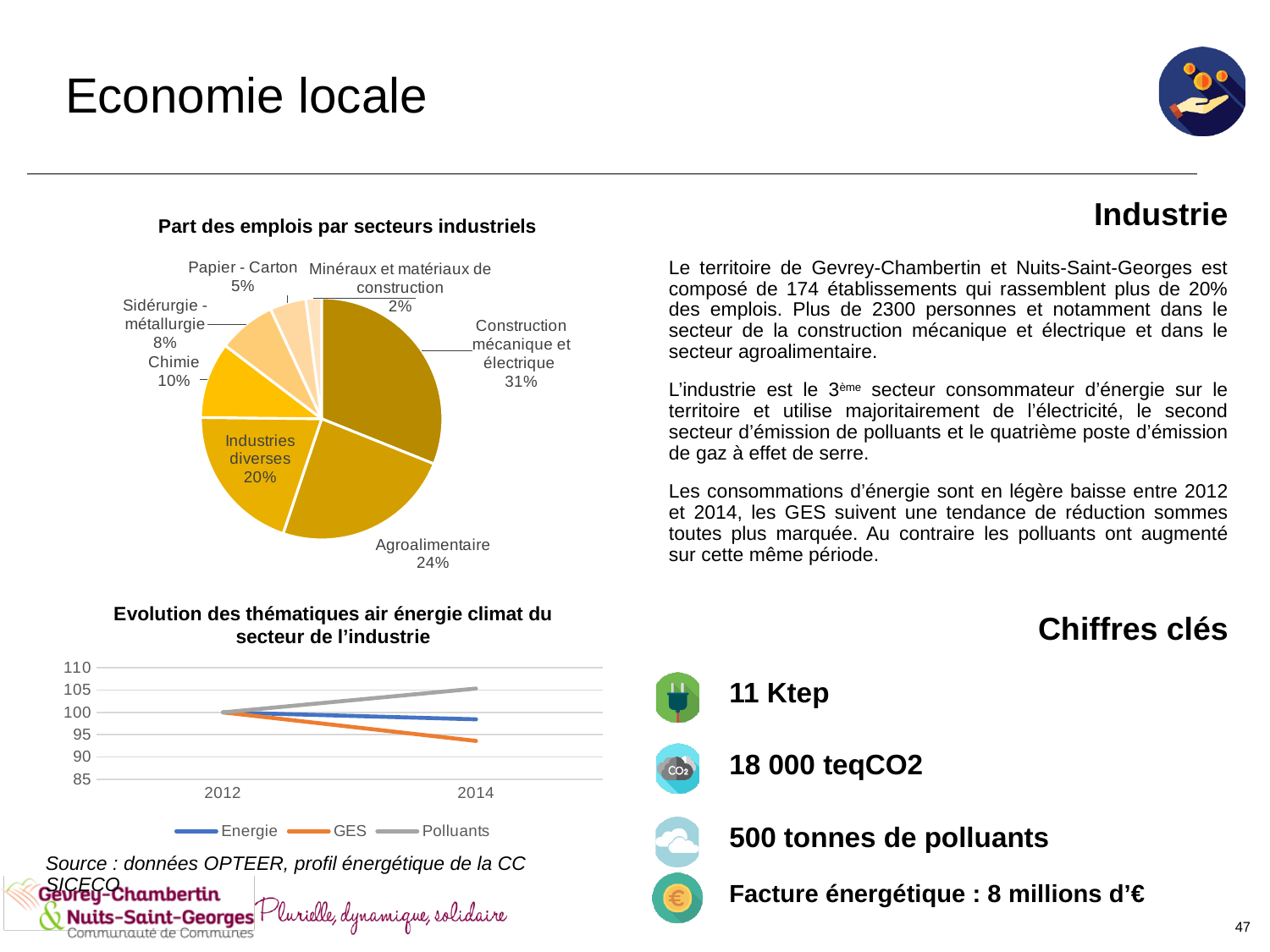
In the pie chart 'Part des emplois par secteurs industriels', what is the difference between the shares of Industries diverses and Chimie? 10% How many series does the legend of the chart 'Evolution des thématiques air énergie climat du secteur de l'industrie' list? 3 In the chart 'Evolution des thématiques air énergie climat du secteur de l'industrie', which series has the lowest value in 2014? GES In the pie chart 'Part des emplois par secteurs industriels', which is larger: Sidérurgie - métallurgie or Papier - Carton? Sidérurgie - métallurgie In the pie chart 'Part des emplois par secteurs industriels', which sector has the smallest share? Minéraux et matériaux de construction What type of chart is 'Part des emplois par secteurs industriels'? Pie chart In the chart 'Evolution des thématiques air énergie climat du secteur de l'industrie', is the value for Polluants in 2014 greater or less than 100? greater In the pie chart 'Part des emplois par secteurs industriels', what share of jobs is in Agroalimentaire? 24% In the pie chart 'Part des emplois par secteurs industriels', which sector has the largest share? Construction mécanique et électrique How many sectors are shown in the pie chart 'Part des emplois par secteurs industriels'? 7 In the pie chart 'Part des emplois par secteurs industriels', what share of jobs is in Construction mécanique et électrique? 31% In the chart 'Evolution des thématiques air énergie climat du secteur de l'industrie', does the GES series rise or fall from 2012 to 2014? Fall